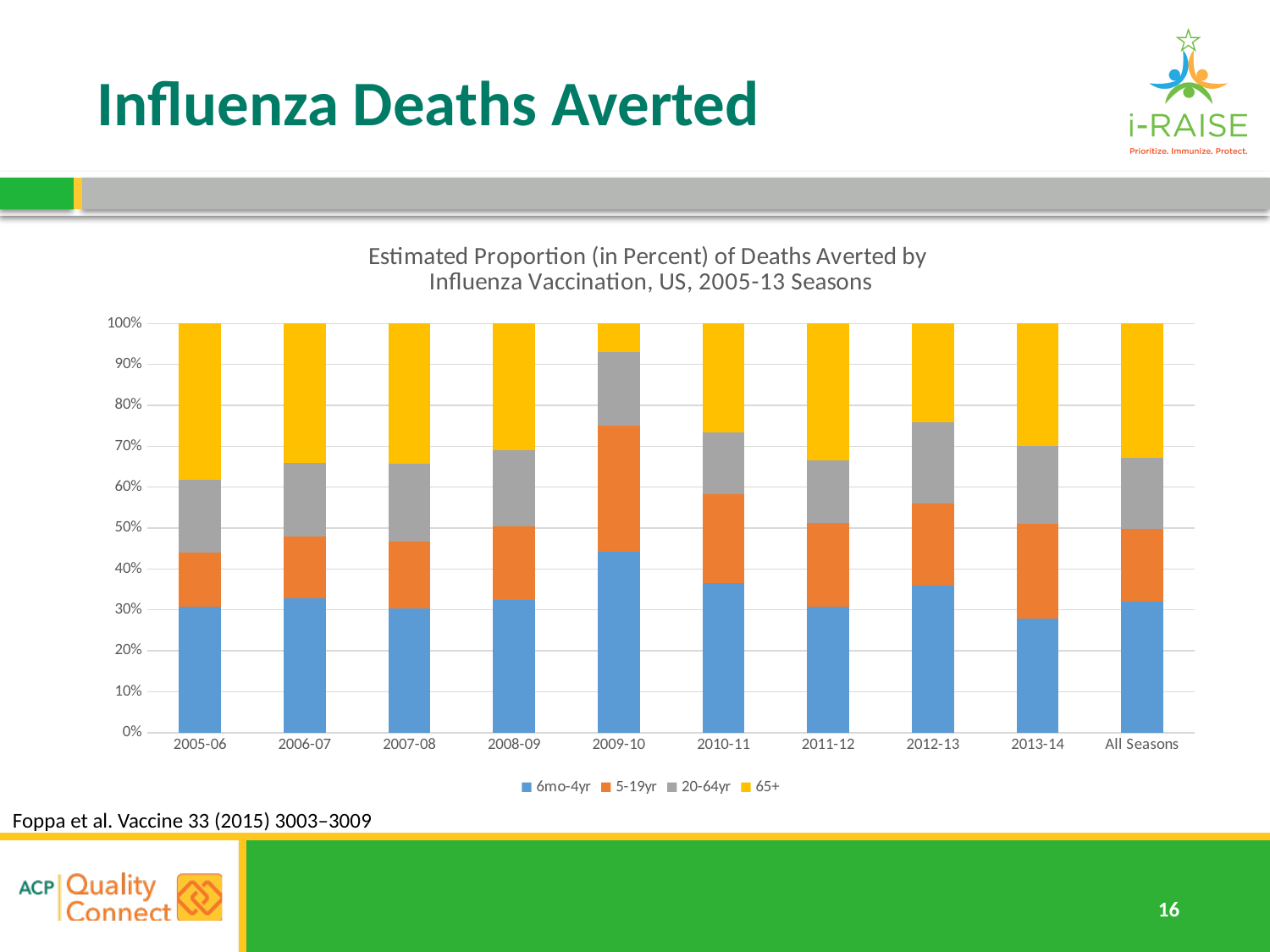
How many categories are shown along the x axis of the chart? 10 Is the 6mo-4yr value for 2010-11 greater or less than 30%? greater What kind of chart is shown on the slide? Stacked bar chart How many series does the chart legend list? 4 What is the title of the chart? Estimated Proportion (in Percent) of Deaths Averted by Influenza Vaccination, US, 2005-13 Seasons Which season has the smallest 65+ segment? 2009-10 Which series is shown in yellow in the chart? 65+ Which season has the larger 5-19yr segment, 2009-10 or 2005-06? 2009-10 What is the total of each stacked bar in the chart? 100% Is the 65+ value for 2009-10 greater or less than 10%? less Which season has the largest 6mo-4yr segment? 2009-10 Is the 6mo-4yr value for 2009-10 greater or less than 40%? greater